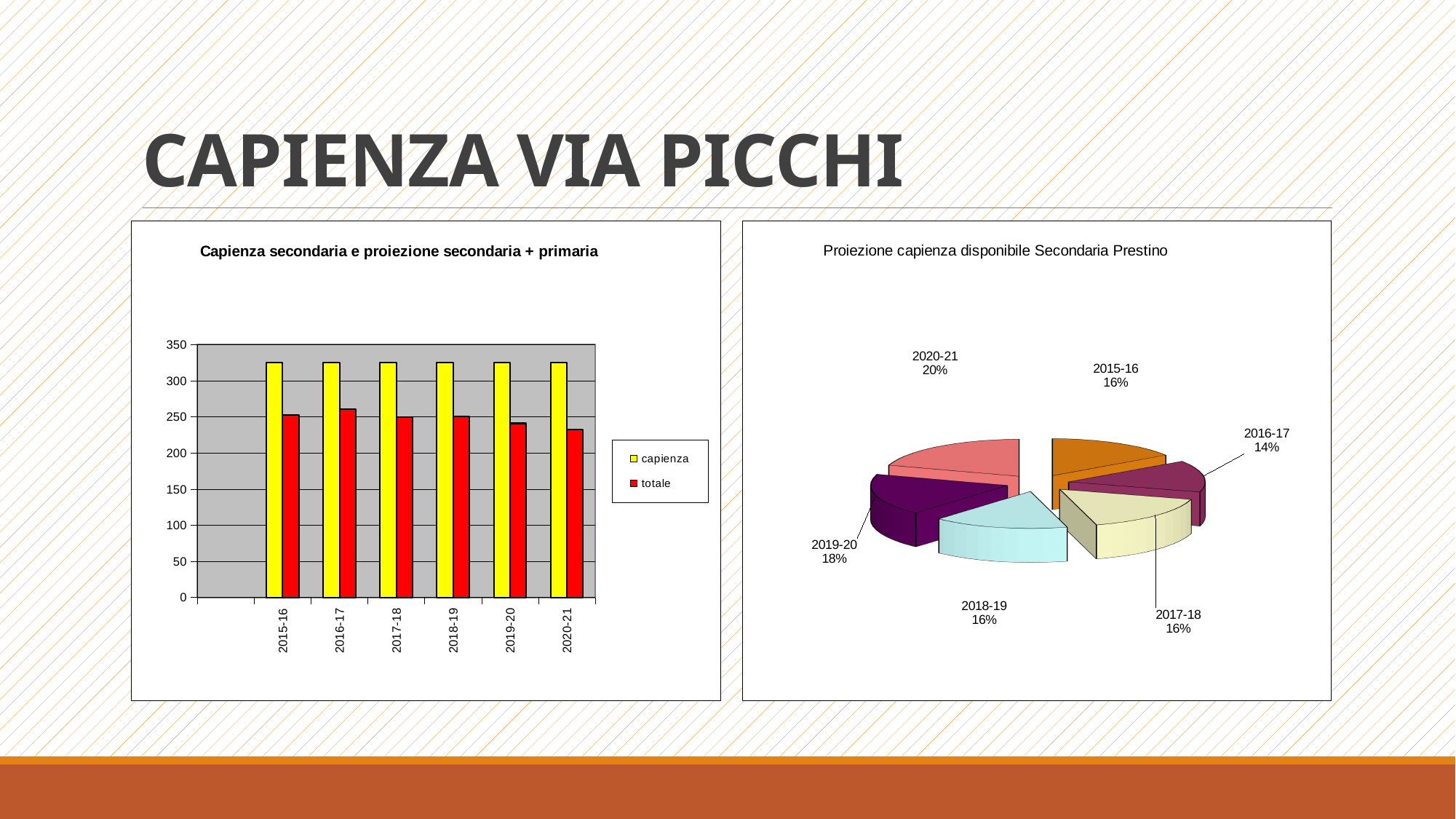
In the pie chart 'Proiezione capienza disponibile Secondaria Prestino', what share does 2020-21 have? 20% In the pie chart 'Proiezione capienza disponibile Secondaria Prestino', how many slices are there? 6 In the pie chart 'Proiezione capienza disponibile Secondaria Prestino', how many percentage points larger is the 2020-21 slice than the 2016-17 slice? 6 percentage points In the chart 'Capienza secondaria e proiezione secondaria + primaria', is the 'totale' value for 2020-21 greater or less than 250? less In the chart 'Capienza secondaria e proiezione secondaria + primaria', which year has the lowest 'totale' bar? 2020-21 In the pie chart 'Proiezione capienza disponibile Secondaria Prestino', which is larger, the 2019-20 slice or the 2018-19 slice? 2019-20 In the chart 'Capienza secondaria e proiezione secondaria + primaria', is the 'capienza' value for 2015-16 greater or less than 300? greater In the pie chart 'Proiezione capienza disponibile Secondaria Prestino', which year has the largest slice? 2020-21 In the pie chart 'Proiezione capienza disponibile Secondaria Prestino', what share does 2016-17 have? 14% In the pie chart 'Proiezione capienza disponibile Secondaria Prestino', which year has the smallest slice? 2016-17 How many series does the legend of the chart 'Capienza secondaria e proiezione secondaria + primaria' list? 2 What kind of chart is 'Capienza secondaria e proiezione secondaria + primaria'? Bar chart